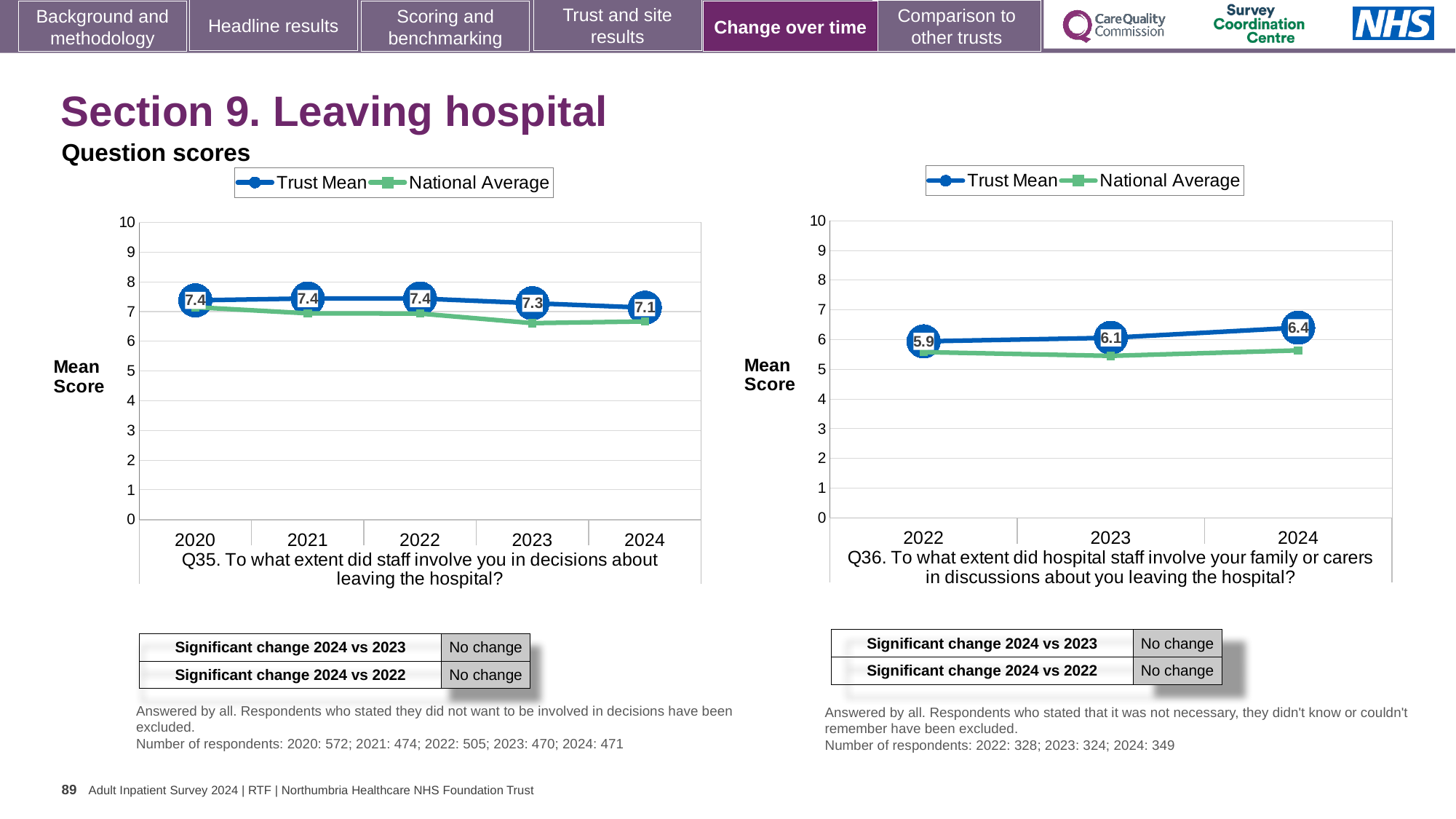
In the Q36 chart on the right, what is the difference between the Trust Mean for 2024 and for 2022? 0.5 In the Q36 chart on the right, what is the Trust Mean for 2024? 6.4 In the Q36 chart on the right, is the National Average for 2023 greater or less than 6? less In the Q35 chart on the left, what is the Trust Mean for 2020? 7.4 How many series does the legend of the Q36 chart on the right list? 2 How many years are plotted on the x axis of the Q35 chart on the left? 5 In the Q35 chart on the left, what is the Trust Mean for 2024? 7.1 In the Q35 chart on the left, which year has the lowest Trust Mean? 2024 In the Q35 chart on the left, what is the difference between the Trust Mean for 2023 and for 2024? 0.2 In the Q36 chart on the right, which year has the highest Trust Mean? 2024 In the Q36 chart on the right, does the Trust Mean rise or fall from 2022 to 2024? rise In the Q36 chart on the right, what is the Trust Mean for 2022? 5.9